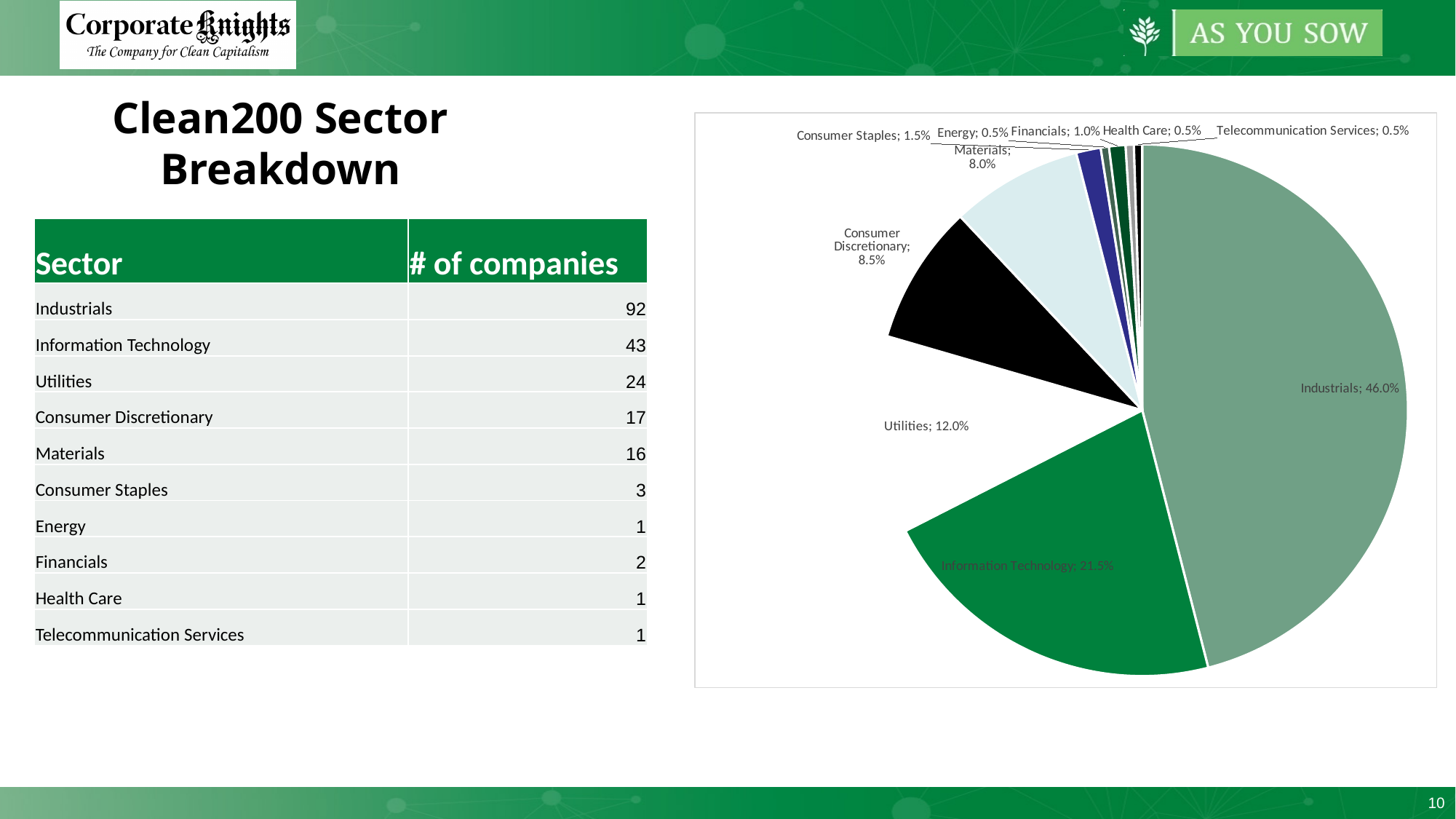
What percentage is shown for Information Technology in the pie chart? 21.5% What percentage is shown for Consumer Staples in the pie chart? 1.5% What share of the pie chart does Industrials have? 46.0% Which sector has the largest slice in the pie chart? Industrials What kind of chart is shown on the slide? pie chart What percentage is shown for Financials in the pie chart? 1.0% What percentage is shown for Materials in the pie chart? 8.0% Which slice is larger in the pie chart, Utilities or Consumer Discretionary? Utilities What is the difference in percentage points between Industrials and Information Technology in the pie chart? 24.5 How many slices does the pie chart have? 10 What percentage is shown for Consumer Discretionary in the pie chart? 8.5% What percentage is shown for Utilities in the pie chart? 12.0%